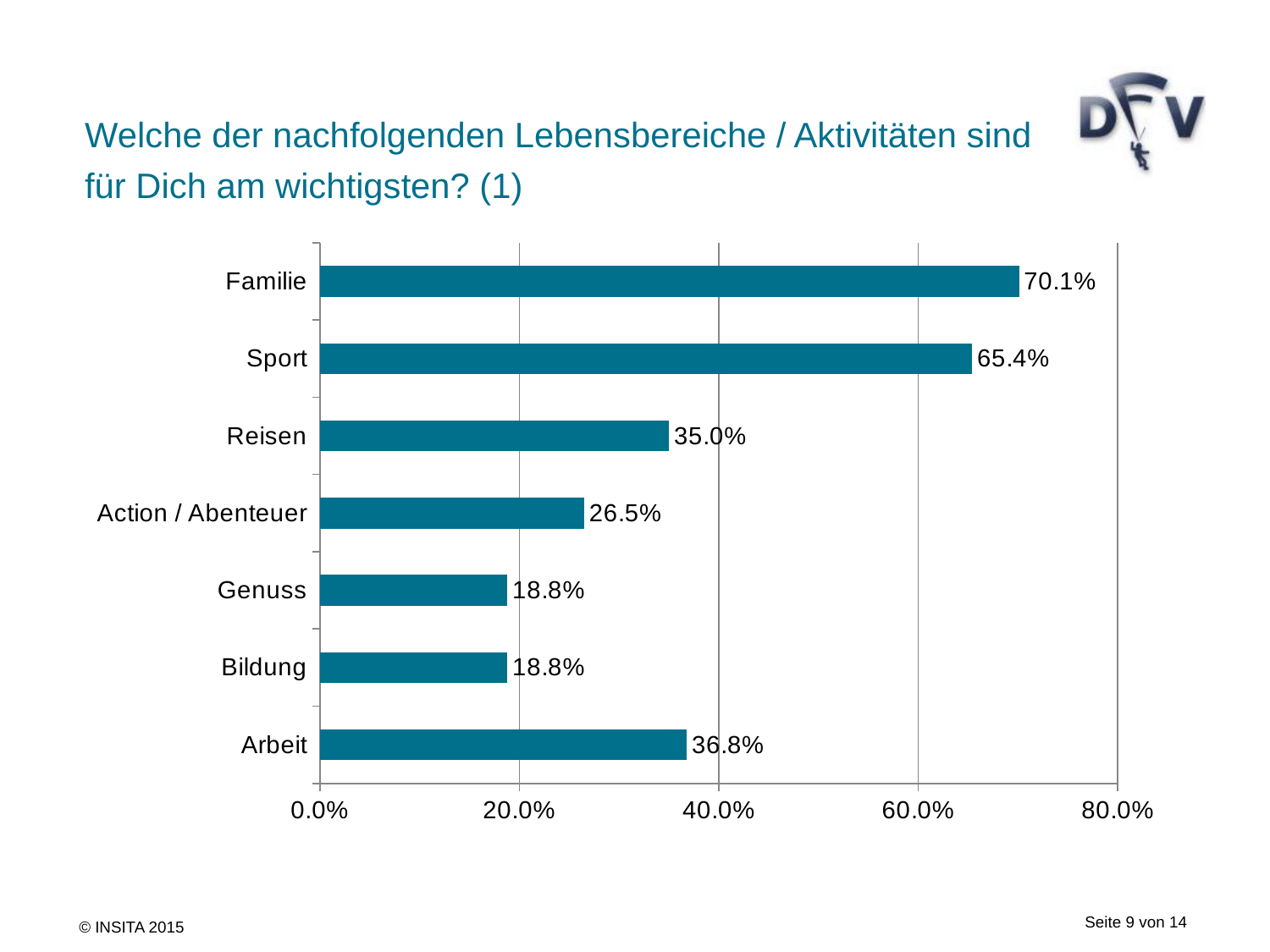
Is the value for Genuss greater or less than 20.0%? less Which two categories have the same value of 18.8%? Genuss and Bildung Which category has the highest value? Familie What is the difference between the values for Familie and Sport? 4.7% What is the value for Action / Abenteuer? 26.5% Which is larger, the value for Reisen or the value for Arbeit? Arbeit What is the value for Arbeit? 36.8% How many categories are shown in the chart? 7 What is the difference between the values for Arbeit and Reisen? 1.8% What kind of chart is shown on the slide? bar chart What is the value for Familie? 70.1% Is the value for Sport greater or less than 60.0%? greater